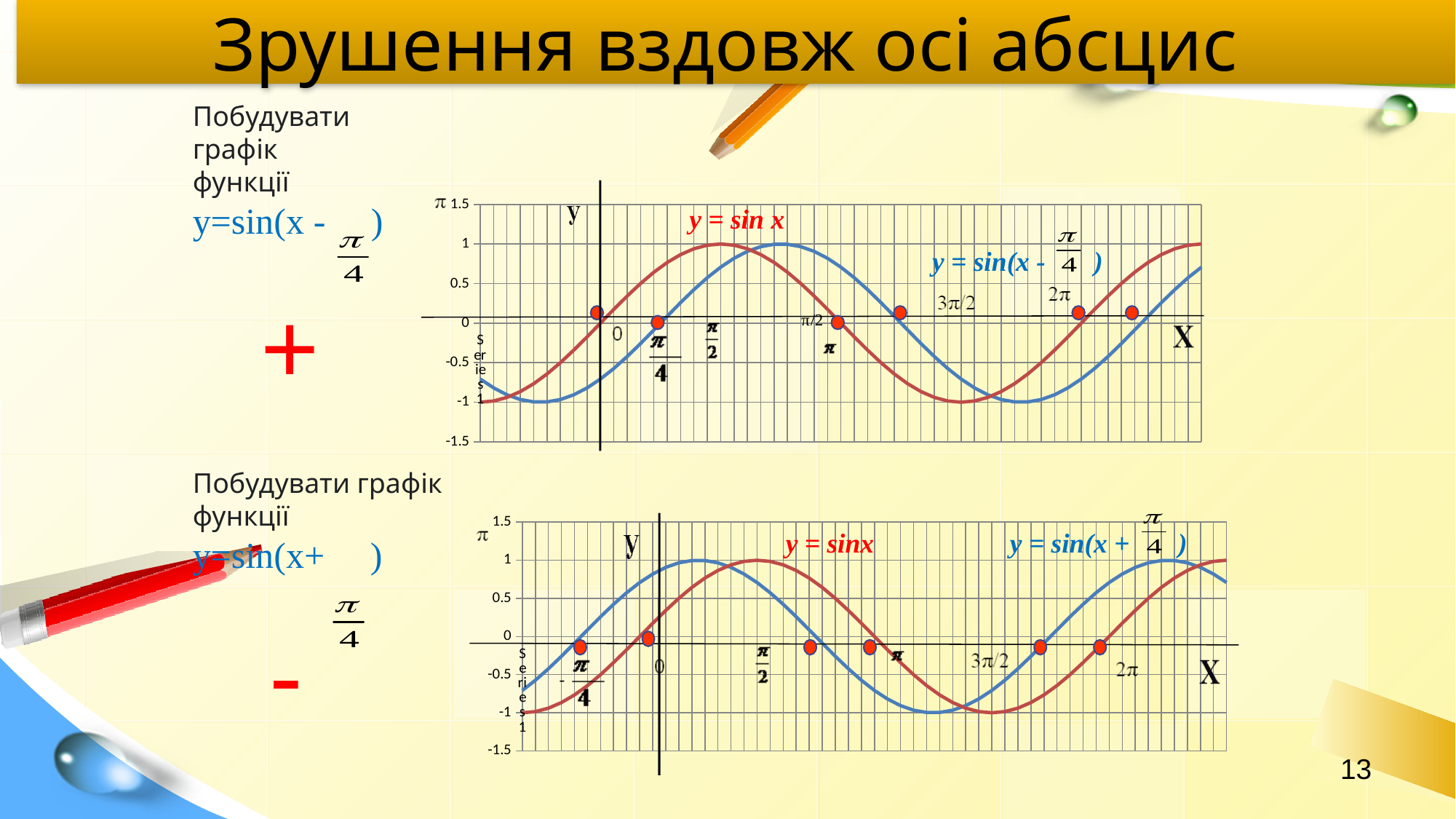
On the bottom chart, which curve reaches its first maximum at a smaller x, y = sinx or y = sin(x + π/4)? y = sin(x + π/4) On the top chart, what colour is the curve y = sin x? red What kind of chart is the top chart on the slide? line chart On the top chart, is the blue curve y = sin(x - π/4) shifted to the left or to the right of the red curve y = sin x? right On the bottom chart, at x = 3π/2, is the value of y = sinx greater or less than -0.5? less On the top chart, at x = π/2, is the value of y = sin x greater or less than 0.5? greater How many curves are plotted on the top chart? 2 On the top chart, what is the value of y = sin x at x = π? 0 On the top chart, what is the highest tick shown on the y axis? 1.5 On the bottom chart, what is the lowest tick shown on the y axis? -1.5 On the top chart, what is the maximum value reached by the curve y = sin x? 1